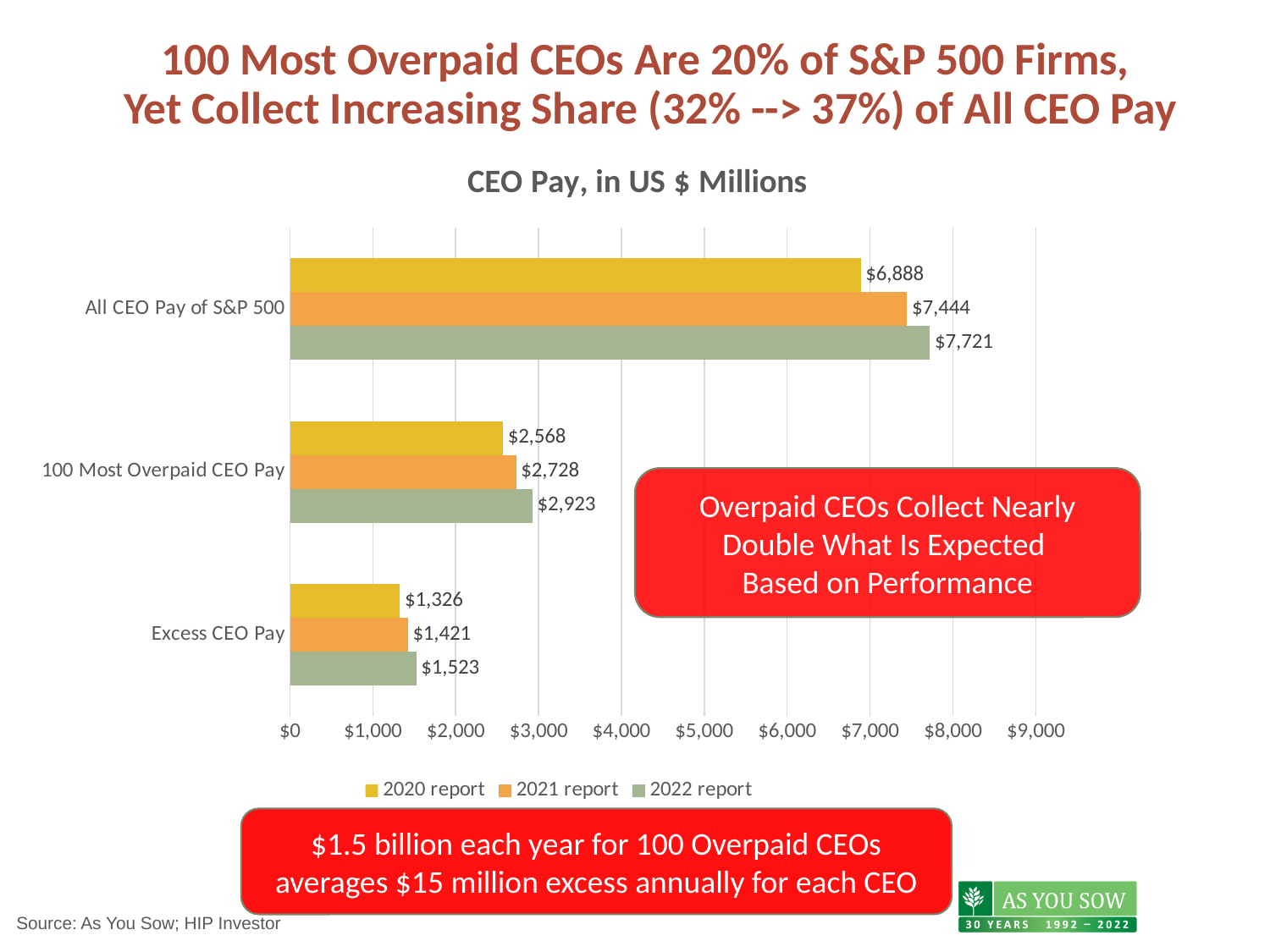
How many series does the legend list? 3 What is the value for Excess CEO Pay in the 2021 report? $1,421 How many categories are shown on the chart? 3 What is the title of the chart? CEO Pay, in US $ Millions What kind of chart is shown on the slide? bar chart What is the value for All CEO Pay of S&P 500 in the 2022 report? $7,721 Which is larger: the 2022 report value for 100 Most Overpaid CEO Pay or the 2021 report value for 100 Most Overpaid CEO Pay? 2022 report What is the difference between the 2022 report and 2020 report values for All CEO Pay of S&P 500? $833 Which category has the highest value in the 2021 report? All CEO Pay of S&P 500 What is the value for 100 Most Overpaid CEO Pay in the 2020 report? $2,568 Is the 2020 report value for Excess CEO Pay greater or less than $2,000? less Which category has the lowest value in the 2022 report? Excess CEO Pay